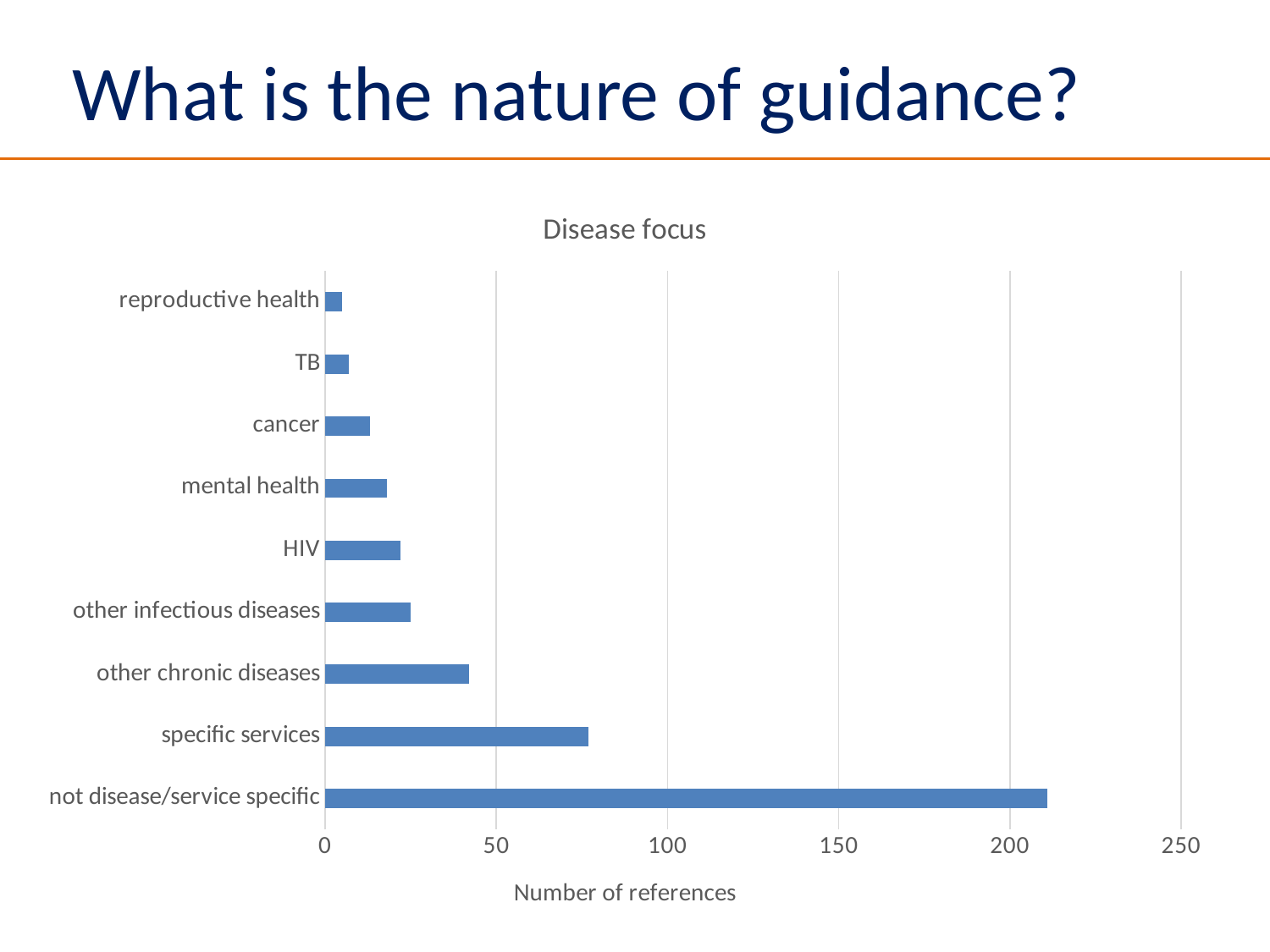
Which has more references, HIV or cancer? HIV Is the value for other chronic diseases greater or less than 50? less How many categories are shown in the Disease focus chart? 9 Is the value for specific services greater or less than 100? less Is the value for specific services greater or less than 50? greater Which has more references, other chronic diseases or other infectious diseases? other chronic diseases What is the label on the horizontal axis of the chart? Number of references Which category has the lowest number of references? reproductive health What kind of chart is shown on the slide? bar chart Which category has the highest number of references? not disease/service specific What is the title of the chart? Disease focus